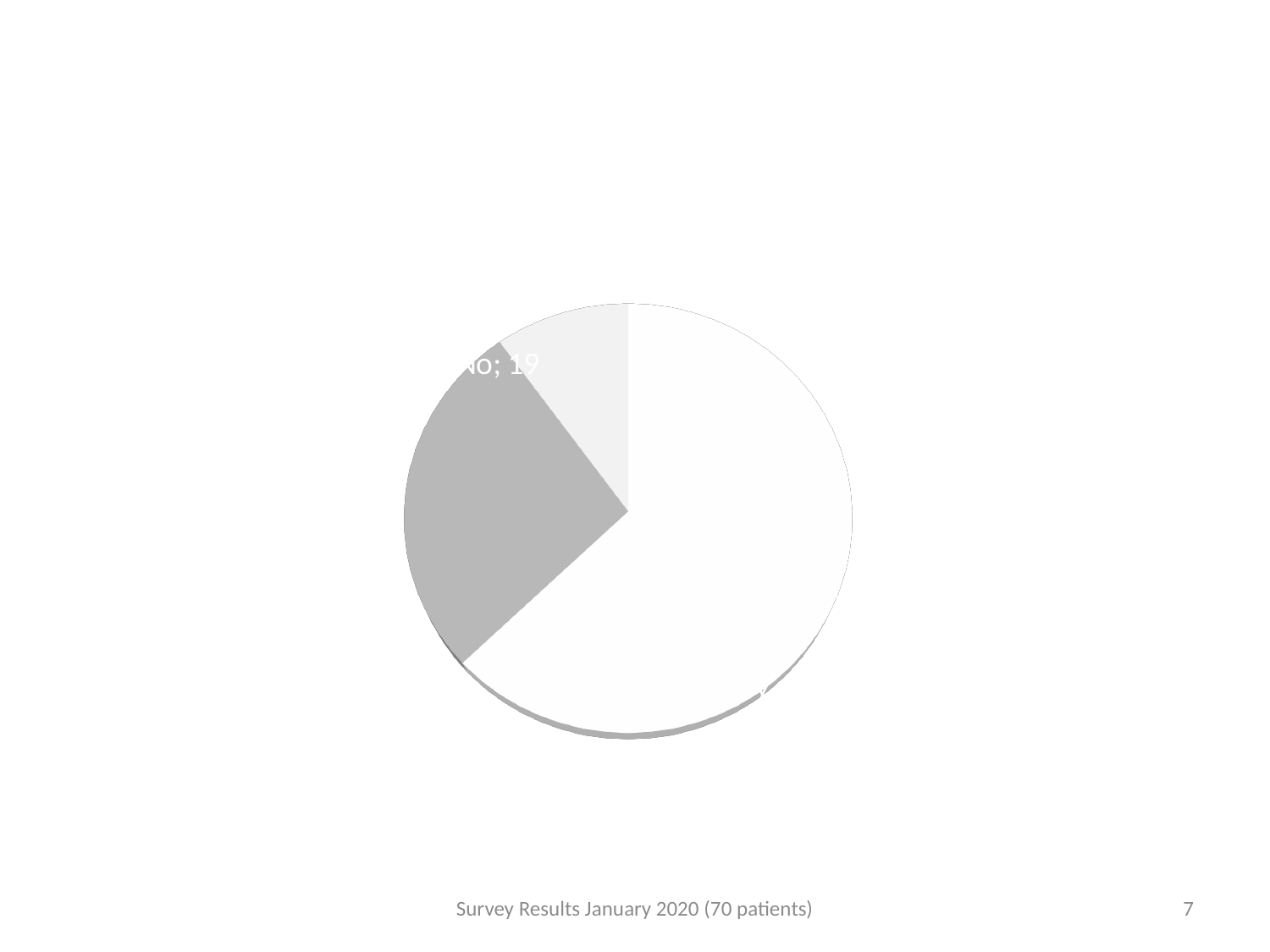
What text appears in the footer below the pie chart? Survey Results January 2020 (70 patients) How many slices does the pie chart have? 3 Is the "No" slice the largest slice of the pie chart? No What kind of chart is shown on the slide? pie chart What value is shown for the "No" slice of the pie chart? 19